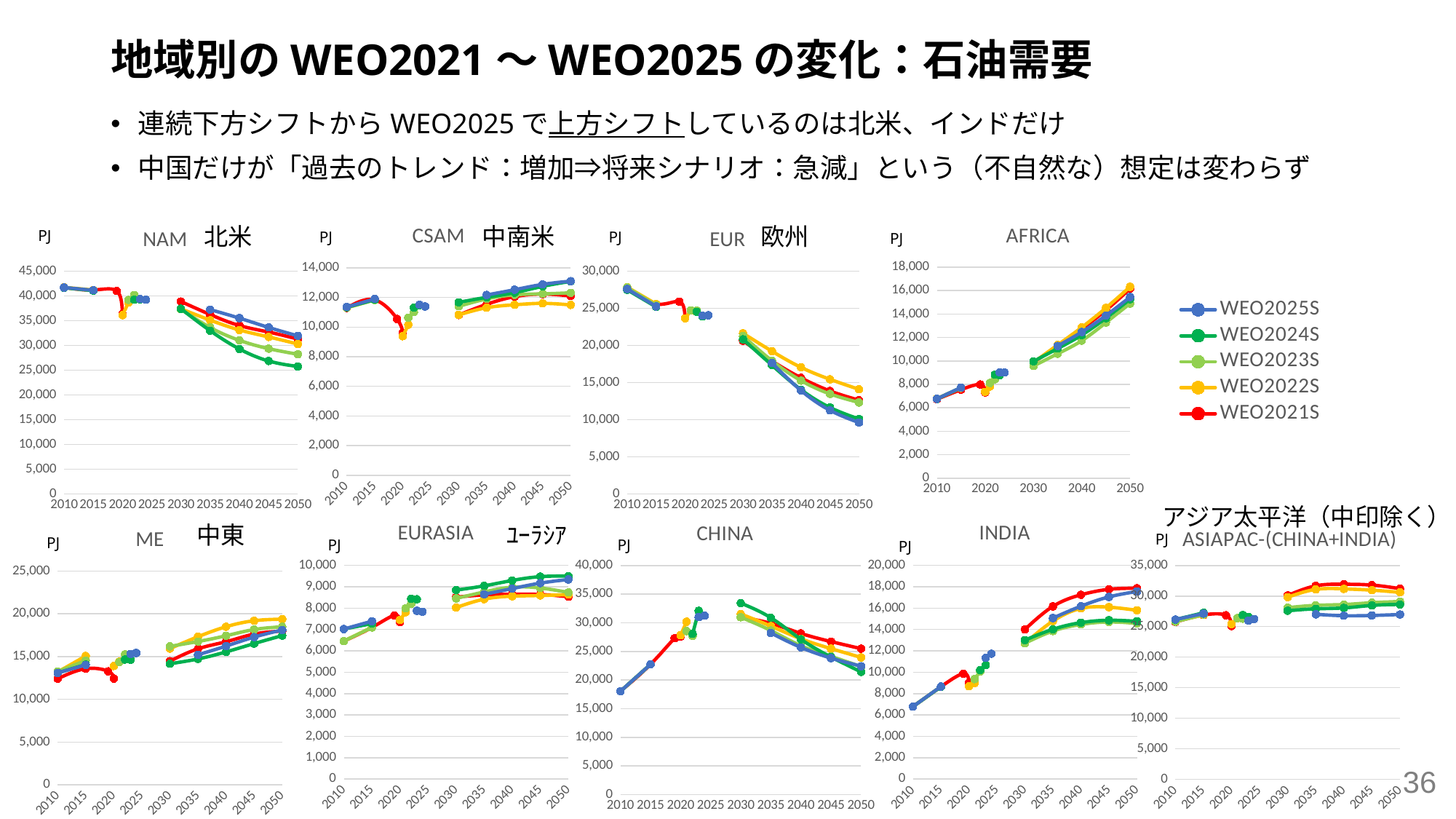
In the NAM (北米) chart, which series is lowest at 2050? WEO2024S In the EUR (欧州) chart, which series is highest at 2050? WEO2022S In the NAM (北米) chart, is the WEO2024S value at 2050 greater or less than 30,000? less How many regional charts are shown on the slide? 9 How many series does the legend list? 5 What kind of chart is used for the NAM (北米) panel? line chart In the CHINA chart, is the WEO2025S value at 2010 greater or less than 20,000? less What unit is shown on the vertical axis of the charts? PJ In the EUR (欧州) chart, do the values rise or fall from 2030 to 2050? fall In the INDIA chart, is the WEO2021S value at 2050 greater or less than 15,000? greater In the AFRICA chart, do the values rise or fall from 2030 to 2050? rise In the CHINA chart, which is larger at 2050: WEO2021S or WEO2024S? WEO2021S